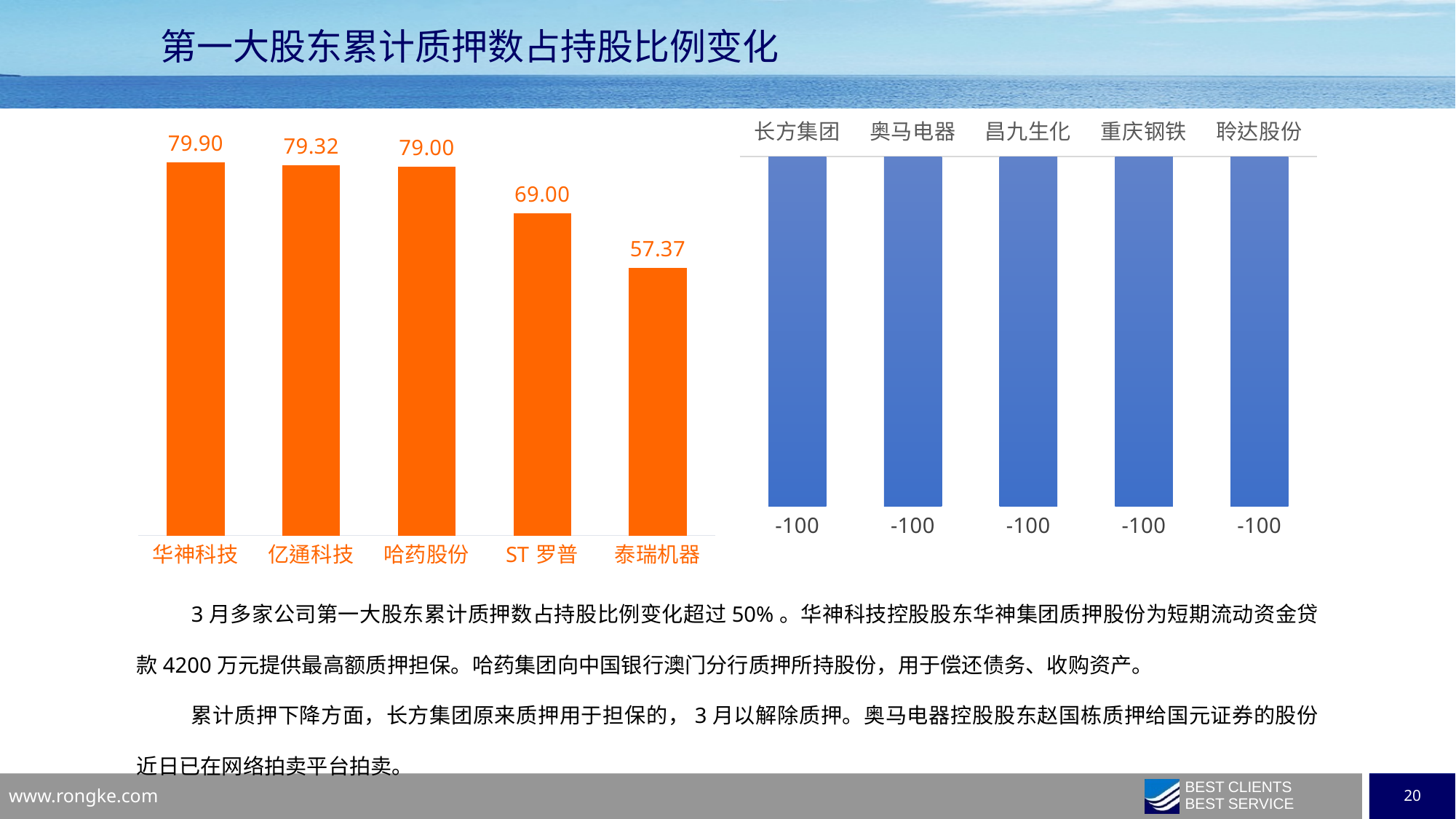
In the right (blue) chart, what is the value for 聆达股份? -100 In the left (orange) chart, what is the value for 华神科技? 79.90 In the left (orange) chart, which is larger, the value for 亿通科技 or the value for 泰瑞机器? 亿通科技 In the left (orange) chart, what is the difference between the values for 哈药股份 and ST 罗普? 10.00 In the right (blue) chart, what is the value for 长方集团? -100 How many categories are shown in the right (blue) chart? 5 In the left (orange) chart, what is the value for 泰瑞机器? 57.37 In the left (orange) chart, what is the value for ST 罗普? 69.00 How many categories are shown in the left (orange) chart? 5 In the left (orange) chart, which category has the lowest value? 泰瑞机器 In the left (orange) chart, which category has the highest value? 华神科技 What type of chart is the left (orange) chart? Bar chart